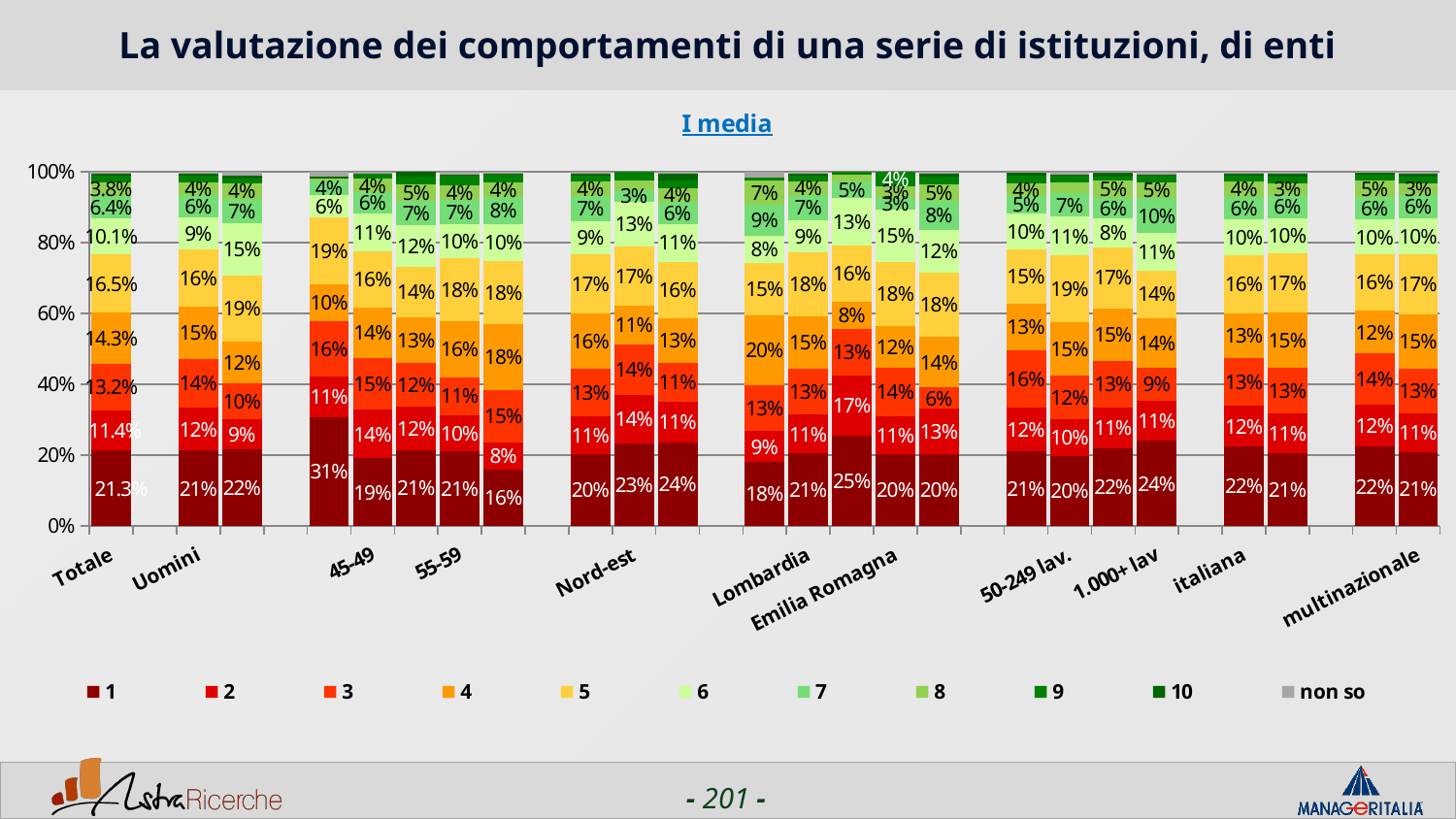
For Totale, which series has the largest share of the bar? 1 How many series does the legend list? 11 What kind of chart is shown on the slide? Stacked bar chart What is the value of series 1 for Uomini? 21% What is the value of series 4 for Uomini? 15% What is the value of series 1 for Totale? 21.3% What is the value of series 6 for Uomini? 9% What is the title of the chart? I media What is the value of series 5 for Totale? 16.5% For Totale, which is larger: series 3 or series 4? 4 What is the last entry in the legend? non so What is the value of series 8 for Totale? 3.8%